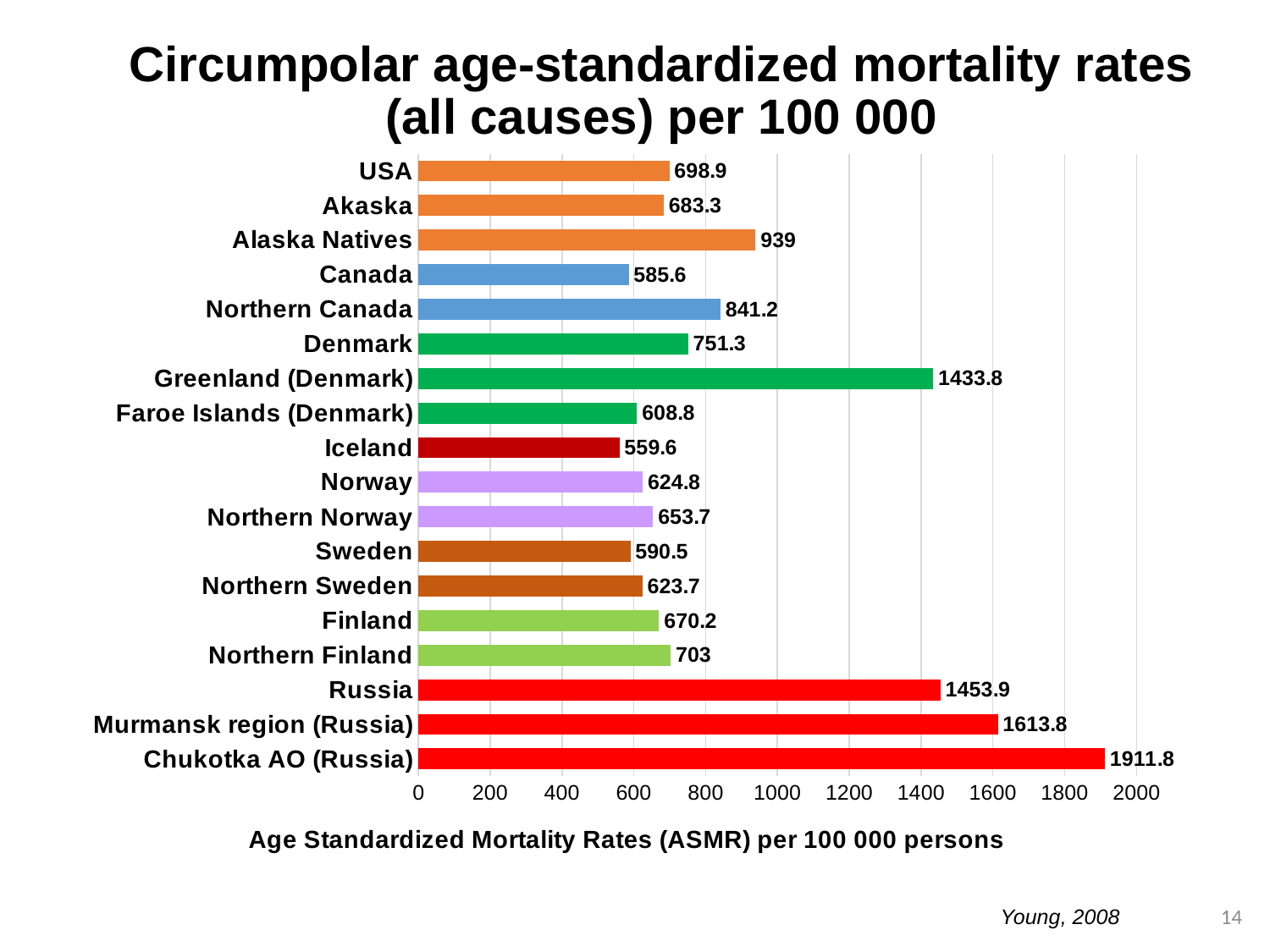
Which has a higher mortality rate, Denmark or Faroe Islands (Denmark)? Denmark Which category has the lowest mortality rate? Iceland What is the label of the horizontal axis? Age Standardized Mortality Rates (ASMR) per 100 000 persons What is the difference between the values for Chukotka AO (Russia) and Murmansk region (Russia)? 298 Which category has the highest mortality rate? Chukotka AO (Russia) What is the difference between the values for Northern Finland and Finland? 32.8 How many categories are plotted in the chart? 18 What is the value shown for Alaska Natives? 939 What is the age-standardized mortality rate for Greenland (Denmark)? 1433.8 What is the value shown for Northern Canada? 841.2 What kind of chart is shown on the slide? Bar chart Which has a higher mortality rate, Russia or Greenland (Denmark)? Russia